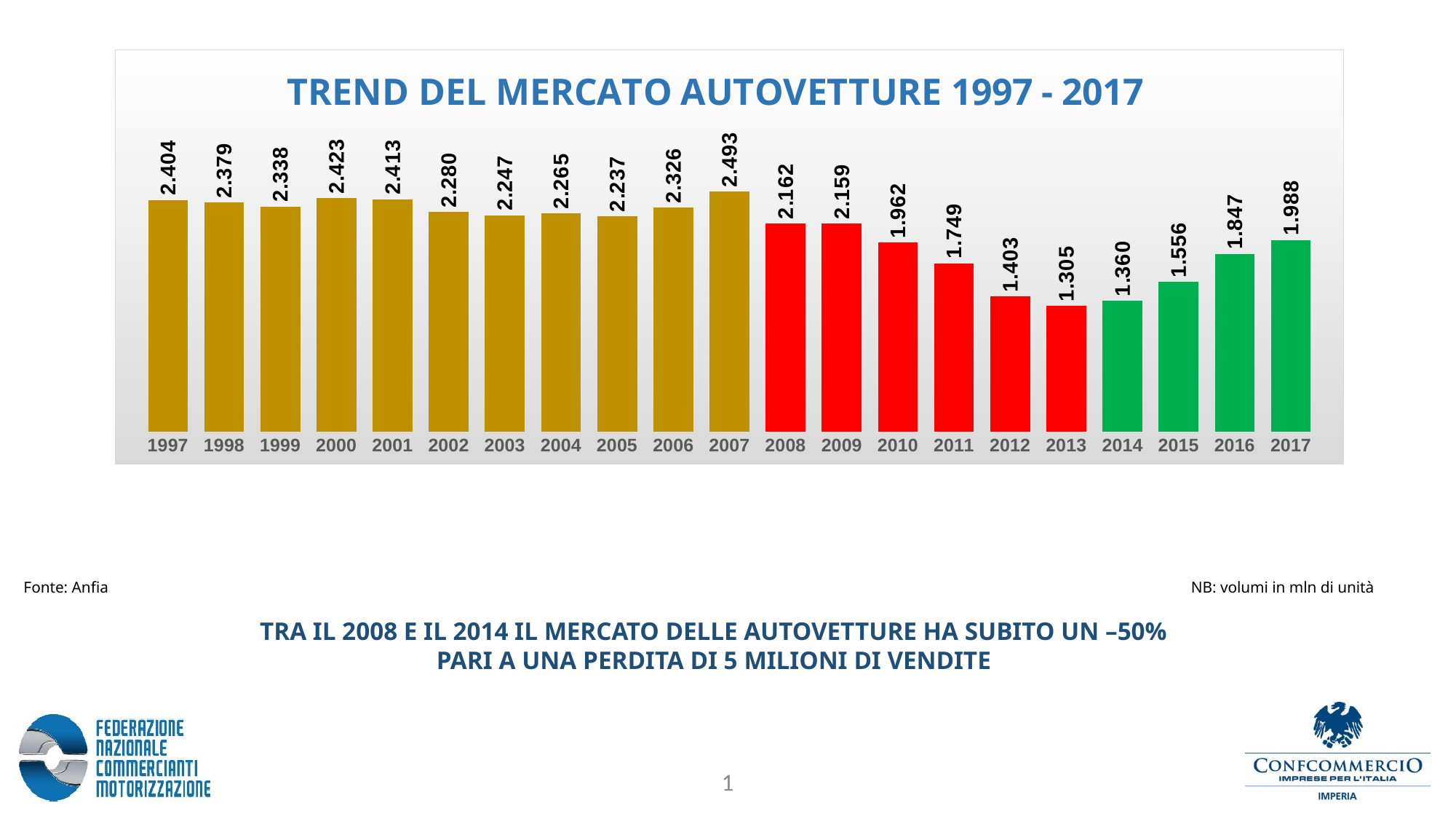
What is the value for 2017? 1.988 What is the difference between the values for 2007 and 2013? 1.188 Which year has the lowest value? 2013 What is the title of the chart? TREND DEL MERCATO AUTOVETTURE 1997 - 2017 What is the value for 2013? 1.305 What kind of chart is shown? Bar chart Which is larger, the value for 2000 or the value for 2002? 2000 How many years are shown on the x axis? 21 Which year has the highest value? 2007 What is the difference between the values for 2017 and 2016? 0.141 What is the value for 2007? 2.493 Do the values rise or fall from 2014 to 2017? Rise